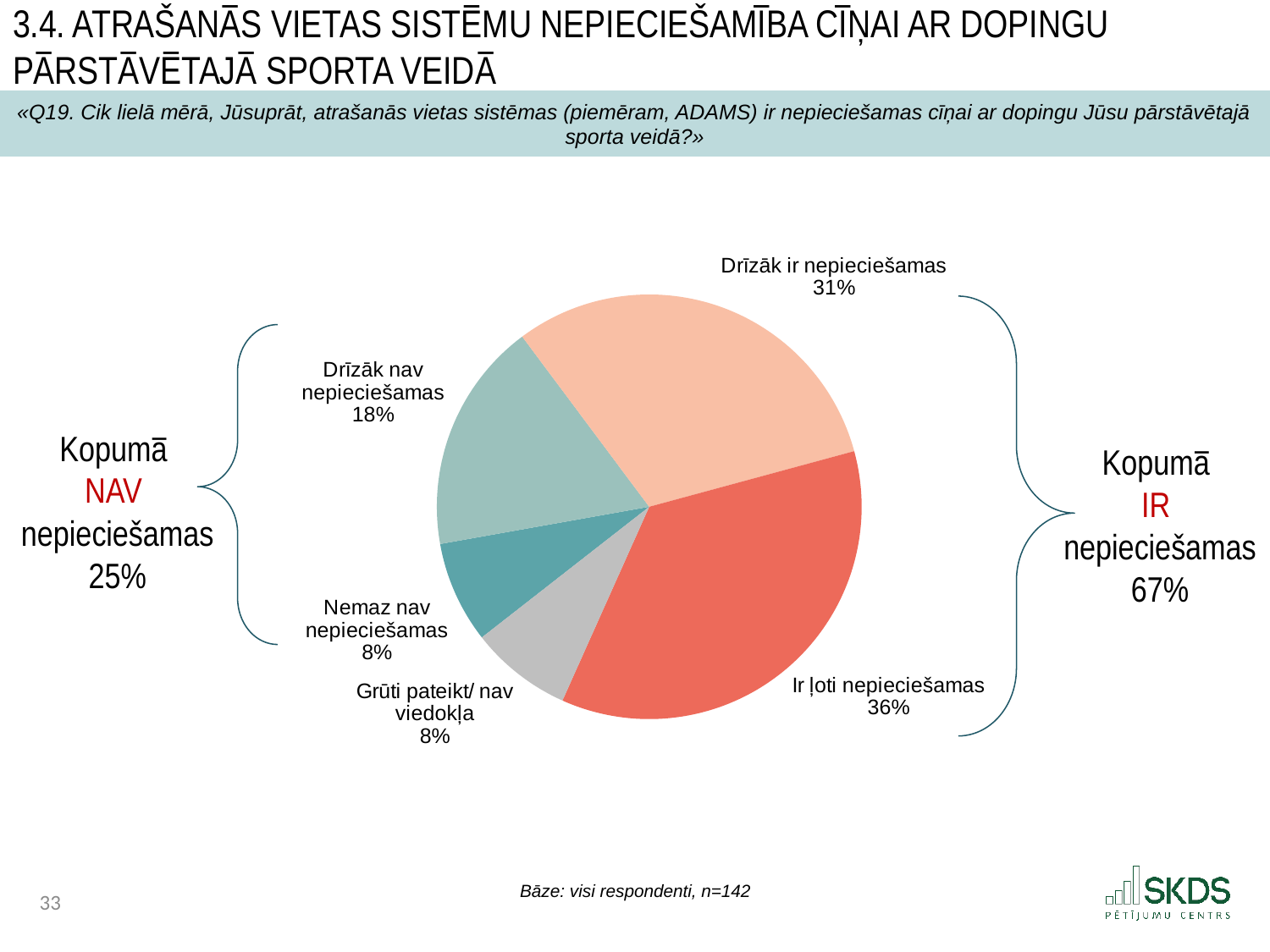
What percentage of respondents answered "Drīzāk nav nepieciešamas"? 18% What is the difference in percentage points between "Ir ļoti nepieciešamas" and "Drīzāk ir nepieciešamas"? 5 percentage points What percentage of respondents answered "Grūti pateikt/ nav viedokļa"? 8% What kind of chart is shown on the slide? pie chart What is the combined share labelled "Kopumā IR nepieciešamas"? 67% Which response category has the largest share of the pie? Ir ļoti nepieciešamas Which is larger: the share for "Drīzāk ir nepieciešamas" or the share for "Drīzāk nav nepieciešamas"? Drīzāk ir nepieciešamas What is the combined share labelled "Kopumā NAV nepieciešamas"? 25% How many slices does the pie chart have? 5 What percentage of respondents answered "Ir ļoti nepieciešamas"? 36% What percentage of respondents answered "Nemaz nav nepieciešamas"? 8% What percentage of respondents answered "Drīzāk ir nepieciešamas"? 31%